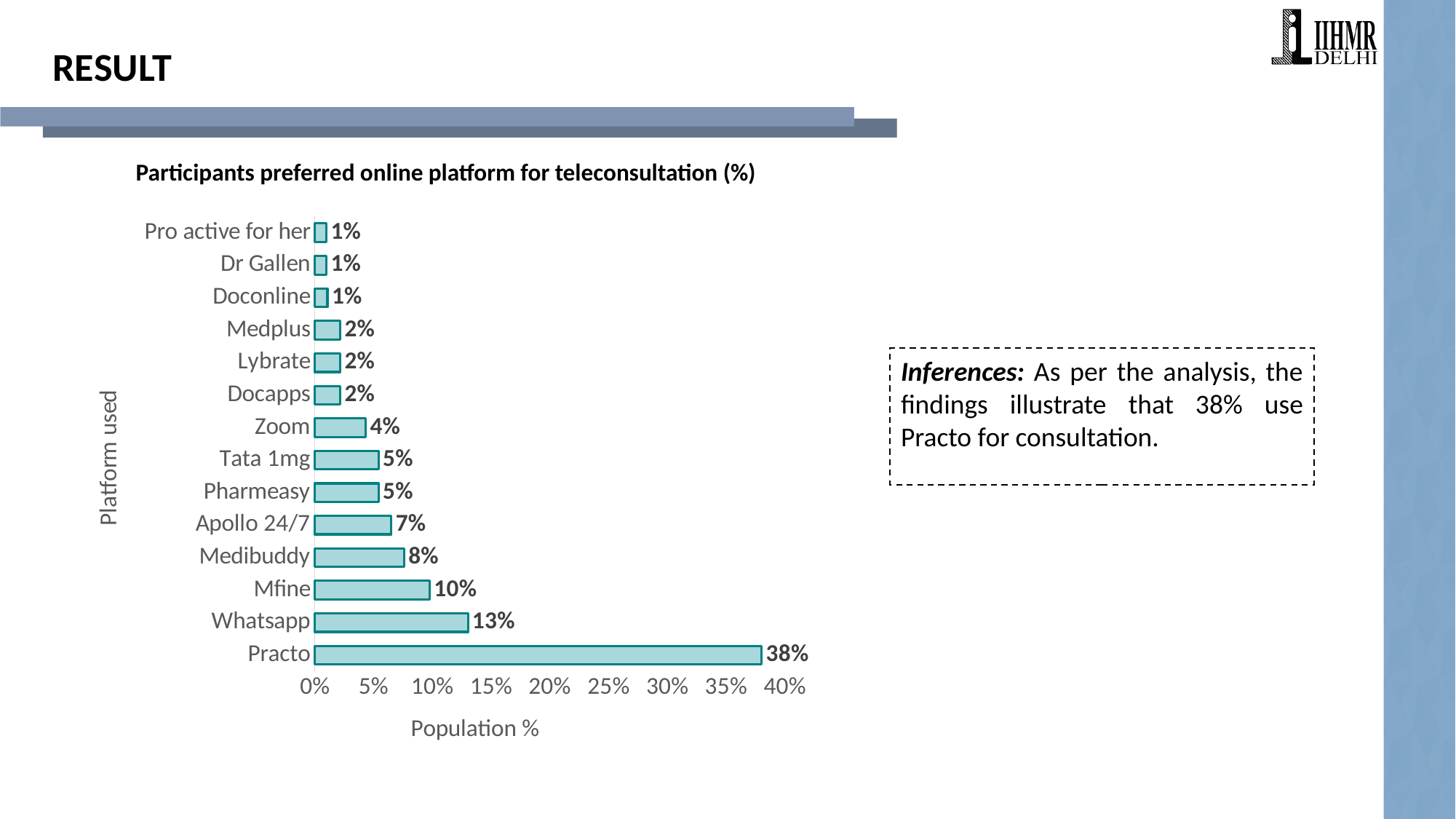
Is the value for Practo greater or less than 35%? greater Which platform has the highest value in the chart? Practo What is the value shown for Whatsapp? 13% What is the title of the chart? Participants preferred online platform for teleconsultation (%) Which has a larger value, Zoom or Medibuddy? Medibuddy What is the difference between the values for Mfine and Apollo 24/7? 3% What is the difference between the values for Practo and Whatsapp? 25% What percentage is shown for Medibuddy? 8% What percentage of participants preferred Practo for teleconsultation? 38% How many platforms are listed in the chart? 14 What is the label of the horizontal axis? Population % What type of chart is shown on the slide? Bar chart